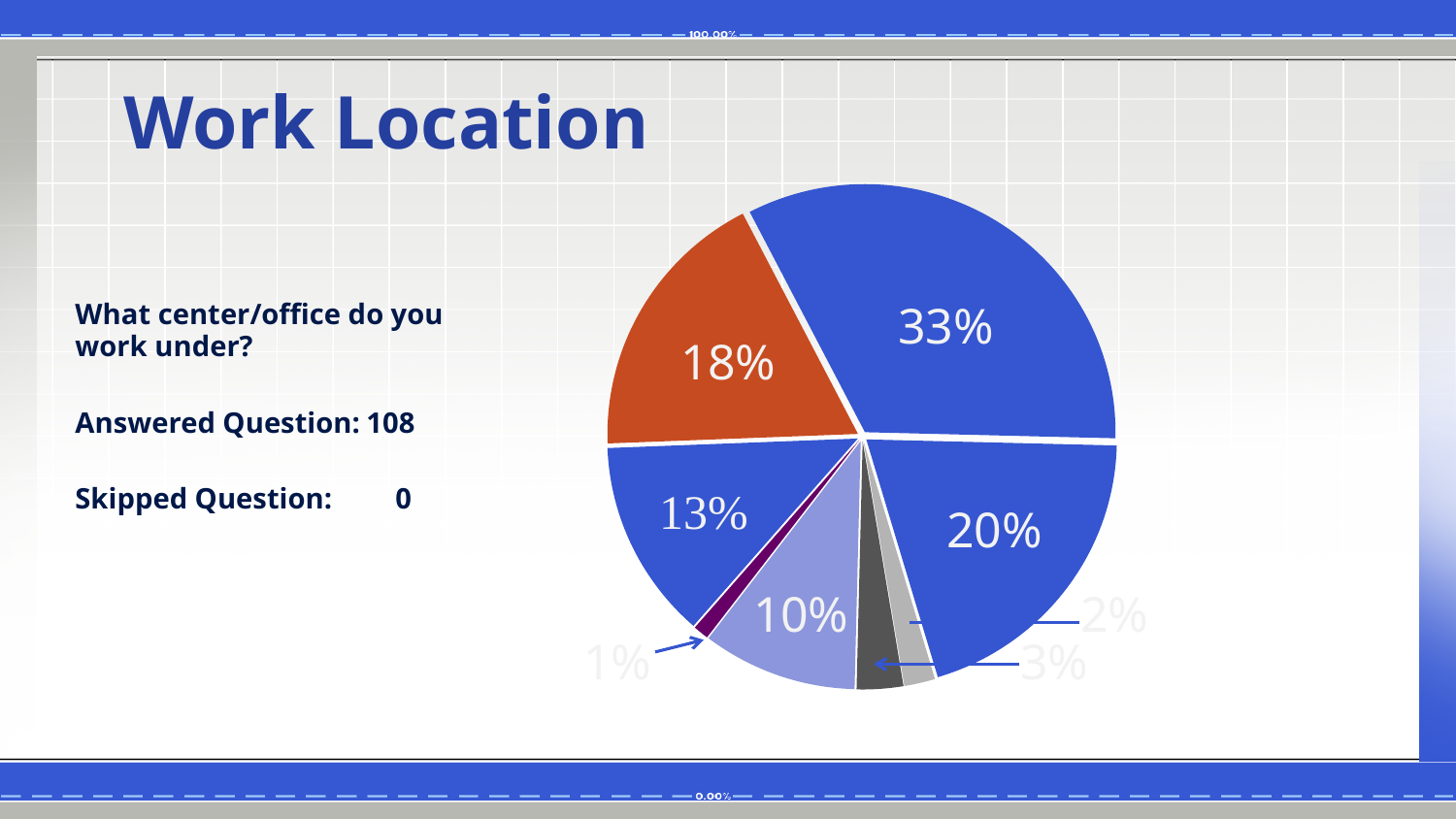
What is the difference in percentage points between the largest slice (33%) and the 20% slice? 13 What is the percentage shown on the smallest slice of the pie chart? 1% What is the difference in percentage points between the orange slice and the light lavender slice? 8 What percentage is shown on the light lavender slice of the pie chart? 10% What is the title of the slide containing the pie chart? Work Location What kind of chart is shown on the slide? pie chart What is the percentage shown on the largest slice of the pie chart? 33% What percentage is shown on the orange slice of the pie chart? 18% Which is larger in the pie chart, the orange slice or the light lavender slice? the orange slice What percentage is shown on the dark grey slice of the pie chart? 3% What percentage is shown on the dark purple slice of the pie chart? 1% How many slices does the pie chart have? 8